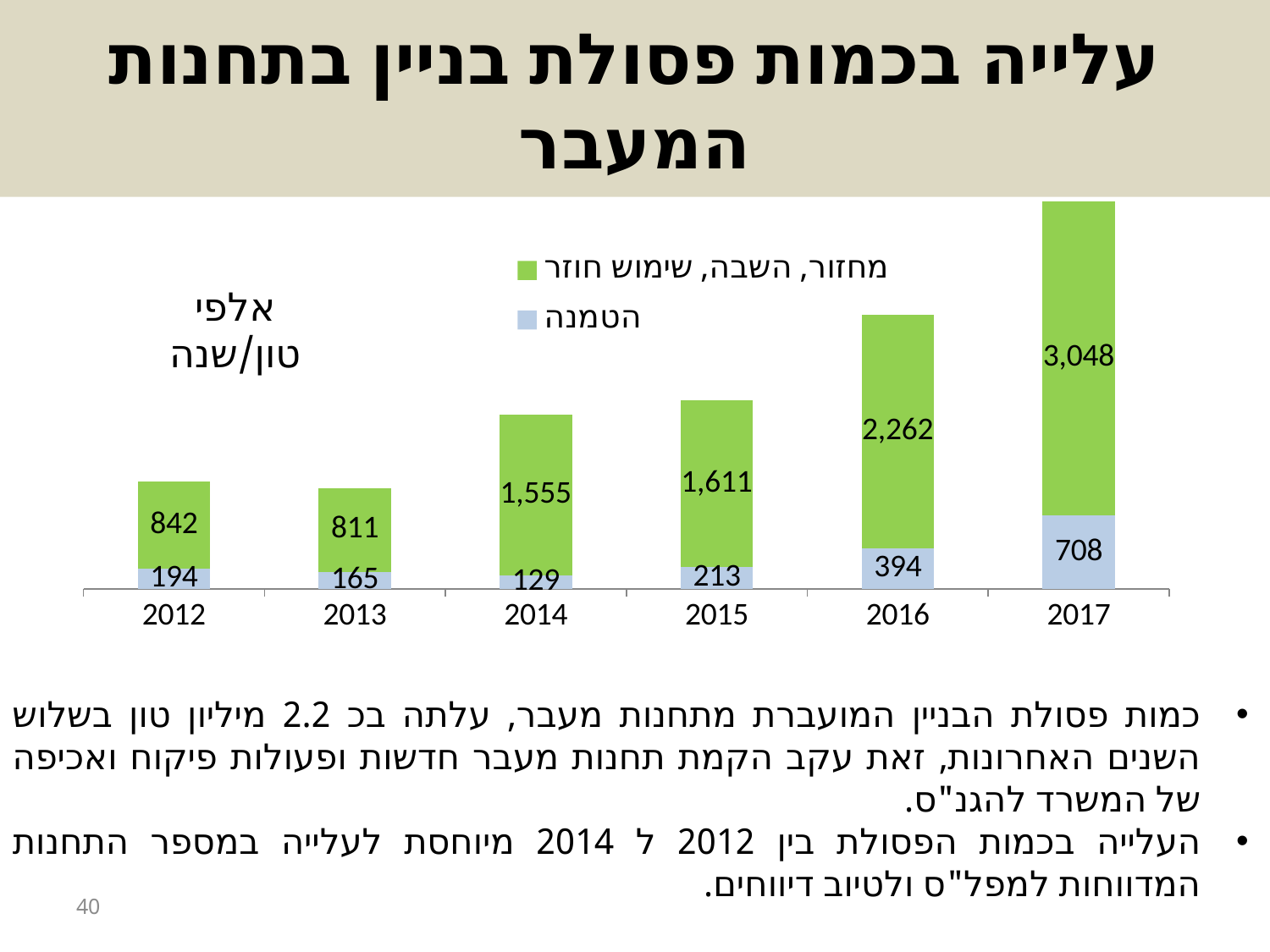
What is the value of the 'הטמנה' series for 2016? 394 How many years are shown on the x axis? 6 What is the total of the stacked bar for 2017? 3,756 Which year has the lowest value for the 'הטמנה' series? 2014 What is the difference between the 'מחזור, השבה, שימוש חוזר' values for 2017 and 2016? 786 Which is larger: the 'הטמנה' value for 2012 or for 2013? 2012 How many series does the legend list? 2 What kind of chart is shown on the slide? Stacked bar chart Which year has the highest value for the 'מחזור, השבה, שימוש חוזר' series? 2017 What is the total of the stacked bar for 2012? 1,036 What is the value of the 'הטמנה' series for 2014? 129 What is the value of the 'מחזור, השבה, שימוש חוזר' series for 2017? 3,048